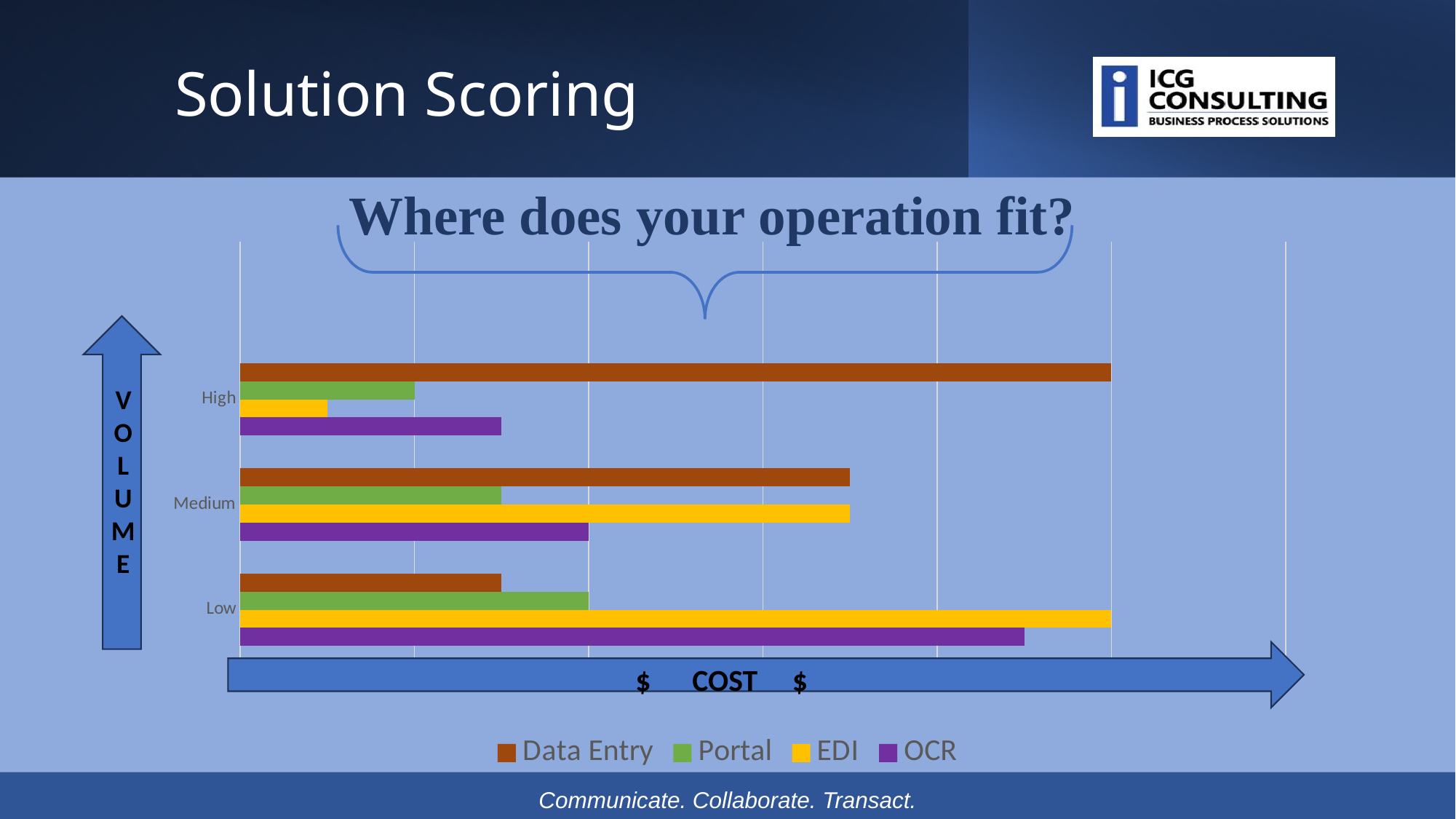
Which series has the shortest bar in the Low volume category? Data Entry What kind of chart is shown on the slide? Bar chart Which series is shown in yellow in the chart legend? EDI Which series has the longest bar in the High volume category? Data Entry Does the Data Entry bar get longer or shorter as volume goes from Low to High? Longer How many volume categories are shown on the chart? 3 In the Medium volume category, which bar is longer: OCR or Portal? OCR How many series does the chart legend list? 4 Which series has the shortest bar in the High volume category? EDI Which series has the longest bar in the Low volume category? EDI Which series has the shortest bar in the Medium volume category? Portal In the High volume category, which bar is longer: Data Entry or OCR? Data Entry